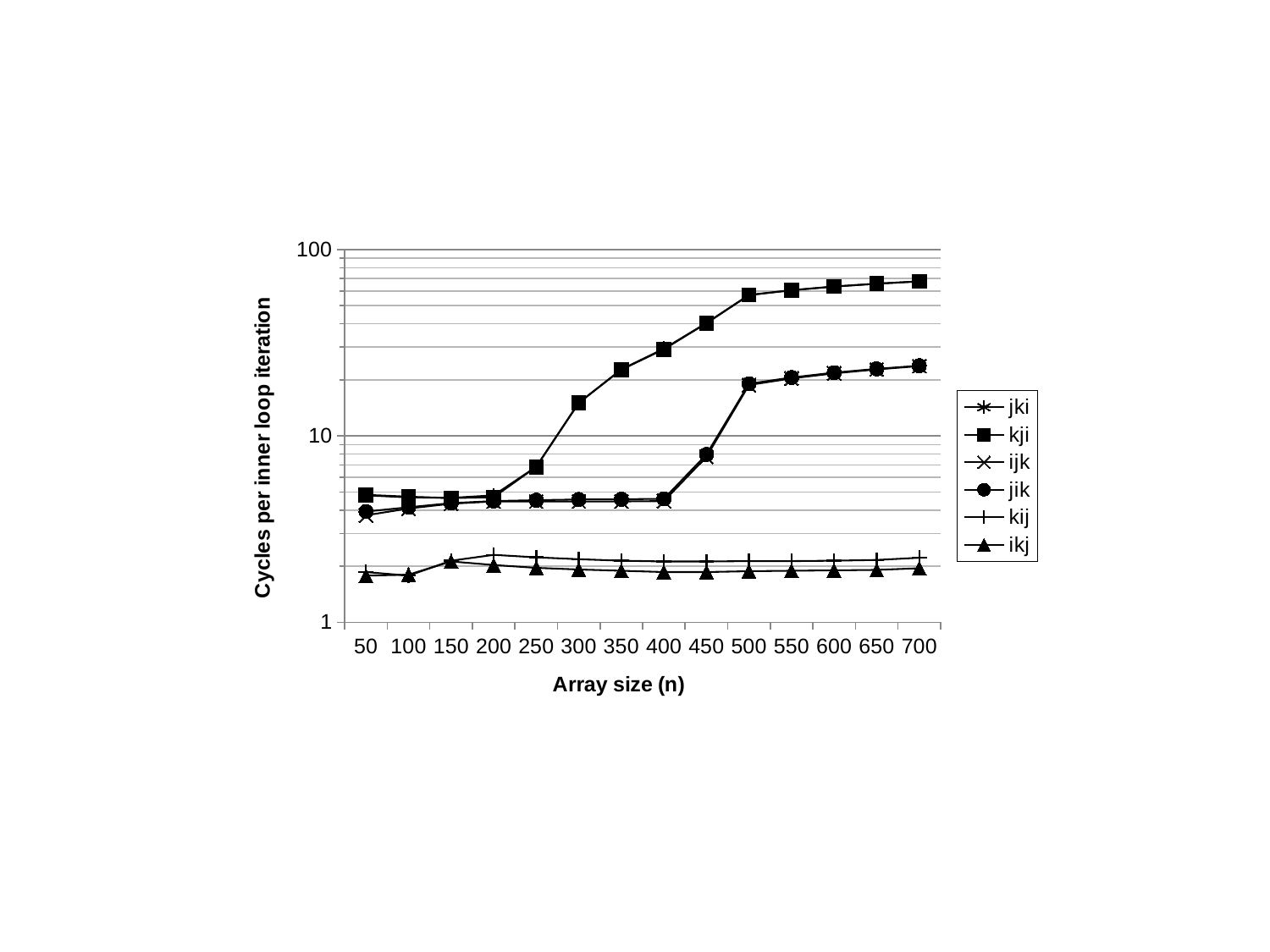
Is the value for jik at array size 400 greater or less than 10? less Do the values for kji rise or fall as array size increases? rise Is the value for kji at array size 50 greater or less than 10? less Is the value for ikj at array size 700 greater or less than 10? less What is the title of the x axis? Array size (n) At array size 700, which is larger, kji or jik? kji What is the title of the y axis? Cycles per inner loop iteration How many array sizes are plotted along the x axis? 14 How many series does the legend list? 6 What kind of chart is shown on the slide? line chart